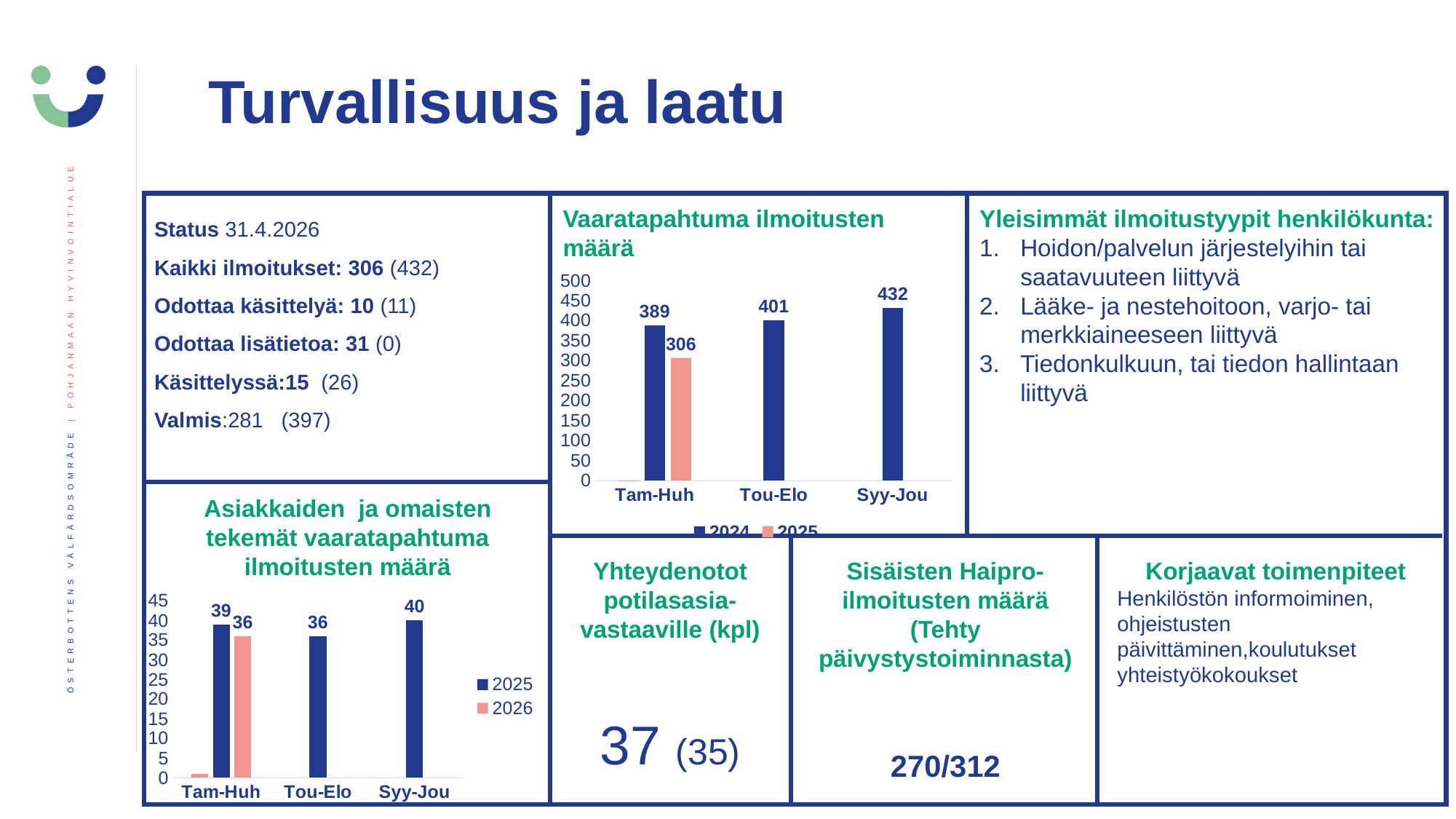
In the chart titled 'Asiakkaiden ja omaisten tekemät vaaratapahtuma ilmoitusten määrä', how many categories are shown on the x axis? 3 In the chart titled 'Asiakkaiden ja omaisten tekemät vaaratapahtuma ilmoitusten määrä', which category has the highest 2025 value? Syy-Jou In the chart titled 'Asiakkaiden ja omaisten tekemät vaaratapahtuma ilmoitusten määrä', what is the difference between the 2025 values for Syy-Jou and Tou-Elo? 4 In the chart titled 'Vaaratapahtuma ilmoitusten määrä', what is the difference between the 2024 and 2025 values for Tam-Huh? 83 In the chart titled 'Vaaratapahtuma ilmoitusten määrä', what is the 2024 value for Syy-Jou? 432 In the chart titled 'Vaaratapahtuma ilmoitusten määrä', which category has the highest 2024 value? Syy-Jou In the chart titled 'Vaaratapahtuma ilmoitusten määrä', how many series does the legend list? 2 In the chart titled 'Asiakkaiden ja omaisten tekemät vaaratapahtuma ilmoitusten määrä', what is the 2025 value for Tou-Elo? 36 What kind of chart is the one titled 'Asiakkaiden ja omaisten tekemät vaaratapahtuma ilmoitusten määrä'? bar chart In the chart titled 'Asiakkaiden ja omaisten tekemät vaaratapahtuma ilmoitusten määrä', what is the 2026 value for Tam-Huh? 36 In the chart titled 'Vaaratapahtuma ilmoitusten määrä', what is the 2025 value for Tam-Huh? 306 In the chart titled 'Vaaratapahtuma ilmoitusten määrä', do the 2024 values rise or fall from Tam-Huh to Syy-Jou? rise